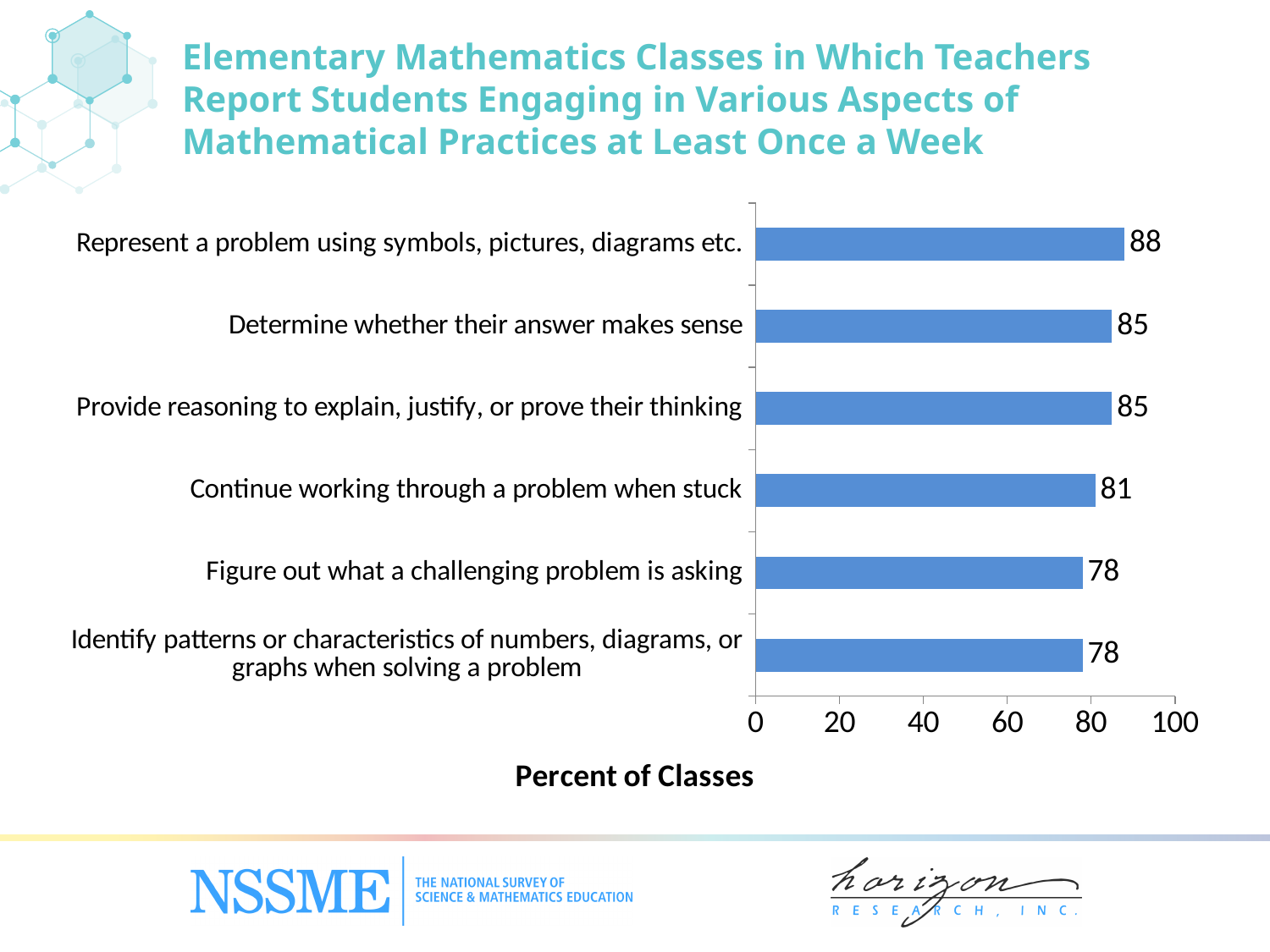
What is the value for "Continue working through a problem when stuck"? 81 What is the difference between the values for "Represent a problem using symbols, pictures, diagrams etc." and "Continue working through a problem when stuck"? 7 Is the value for "Identify patterns or characteristics of numbers, diagrams, or graphs when solving a problem" greater or less than 80? less What kind of chart is shown on the slide? Bar chart What is the value for "Figure out what a challenging problem is asking"? 78 How many categories are shown in the chart? 6 Which category has the highest percent of classes? Represent a problem using symbols, pictures, diagrams etc. What is the value for "Determine whether their answer makes sense"? 85 What percent of classes is reported for "Represent a problem using symbols, pictures, diagrams etc."? 88 What is the label of the horizontal axis? Percent of Classes What is the difference between the values for "Determine whether their answer makes sense" and "Figure out what a challenging problem is asking"? 7 Which is larger: the value for "Provide reasoning to explain, justify, or prove their thinking" or the value for "Figure out what a challenging problem is asking"? Provide reasoning to explain, justify, or prove their thinking